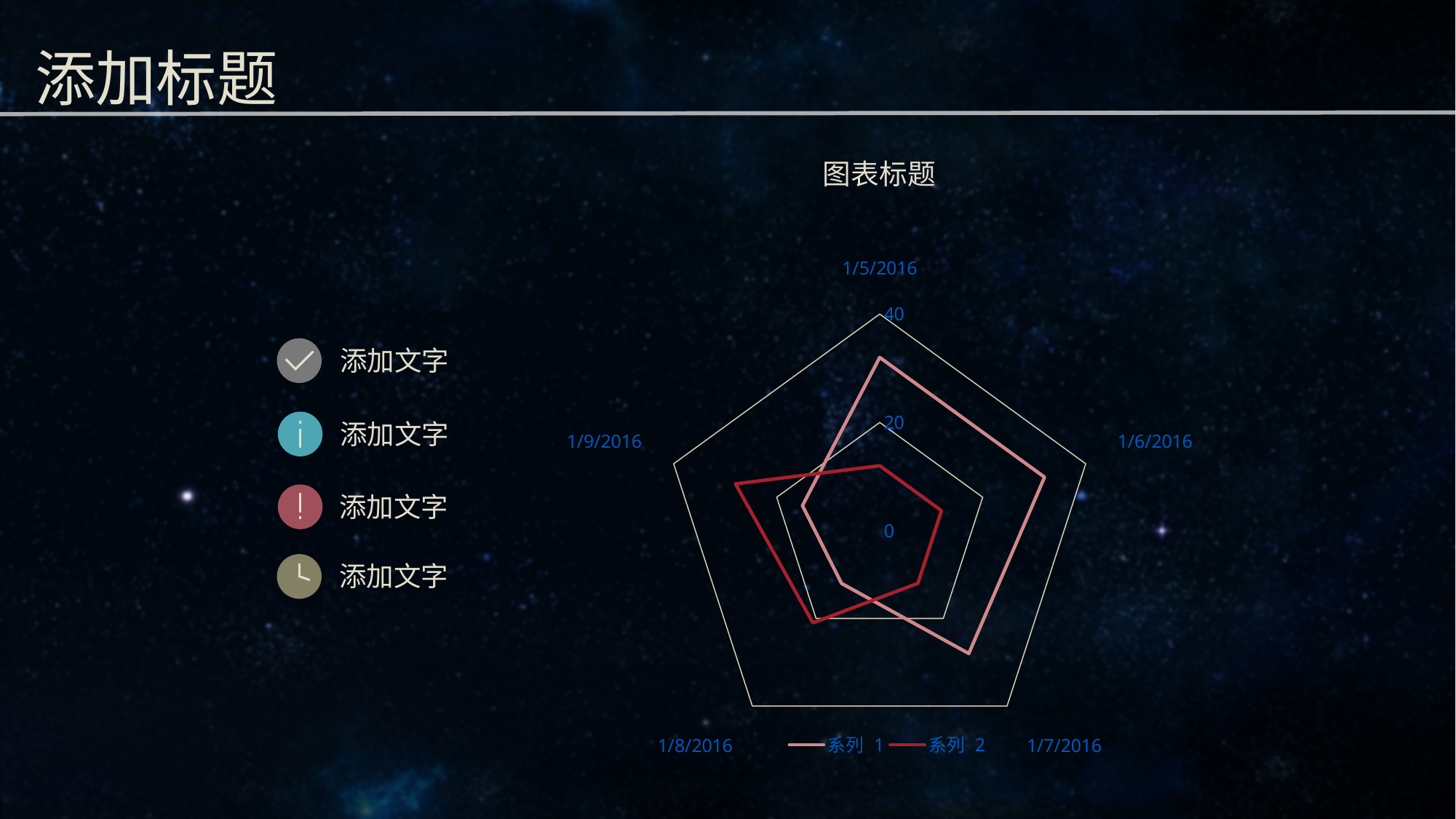
Is the value of 系列 1 for 1/5/2016 greater or less than 20? greater What is the title of the chart? 图表标题 Is the value of 系列 1 for 1/8/2016 greater or less than 20? less For 1/5/2016, which series has the larger value, 系列 1 or 系列 2? 系列 1 What are the names of the two series in the legend? 系列 1 and 系列 2 For which date does 系列 2 have its highest value? 1/9/2016 How many series does the legend of the radar chart list? 2 What kind of chart is shown on the slide? Radar chart Is the value of 系列 1 for 1/6/2016 greater or less than 20? greater How many categories (dates) does the radar chart have? 5